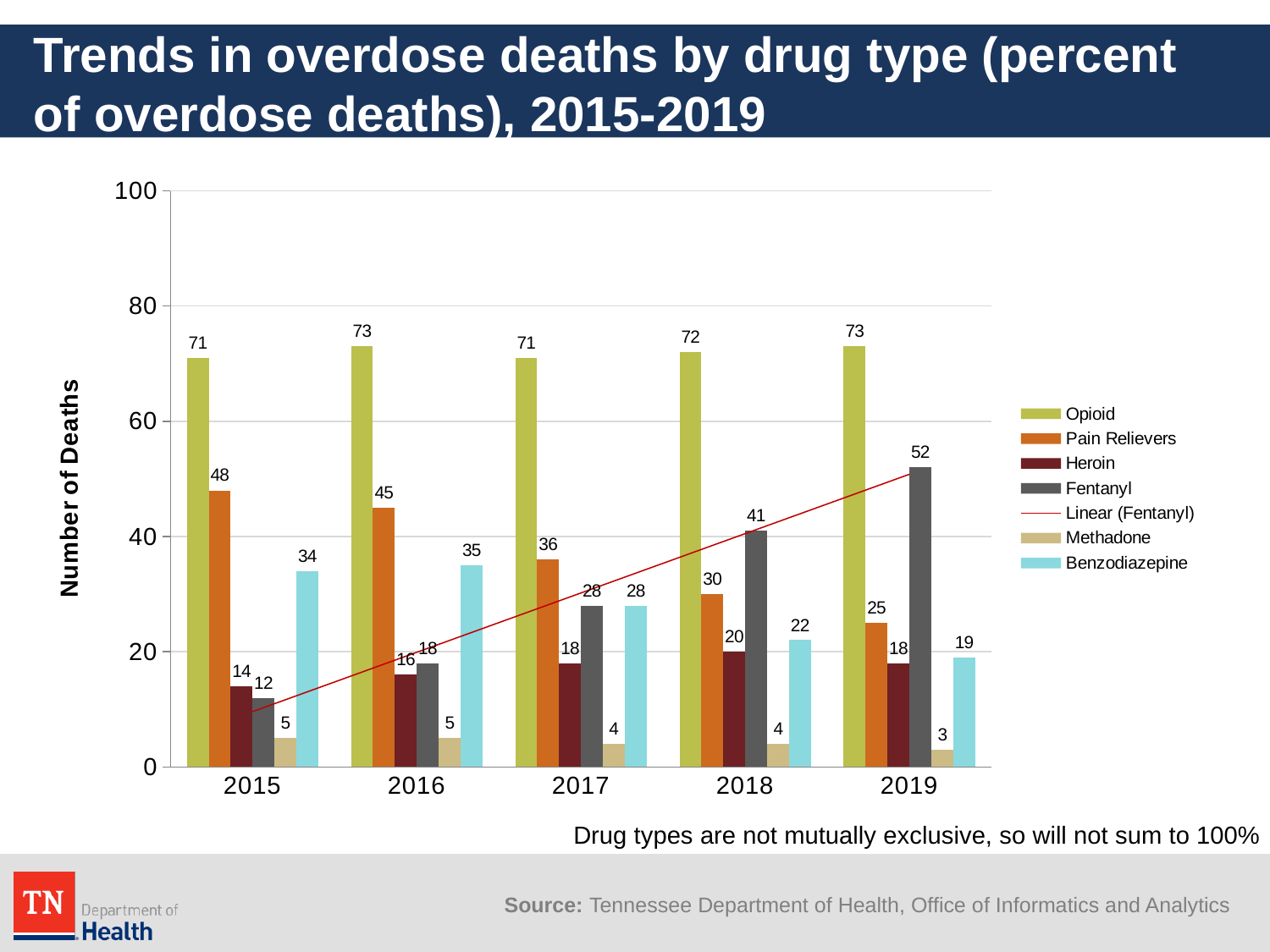
In which year is the Fentanyl value highest? 2019 What is the difference between the Fentanyl values in 2019 and 2015? 40 How many entries does the legend list? 7 What is the value for Methadone in 2019? 3 Which is larger in 2018, the Fentanyl value or the Pain Relievers value? Fentanyl What is the value for Pain Relievers in 2015? 48 How many years are shown on the x axis? 5 What kind of chart is shown on the slide? Bar chart In which year is the Pain Relievers value lowest? 2019 How does the Pain Relievers value change from 2015 to 2019? It falls What is the value for Fentanyl in 2019? 52 What is the value for Benzodiazepine in 2017? 28